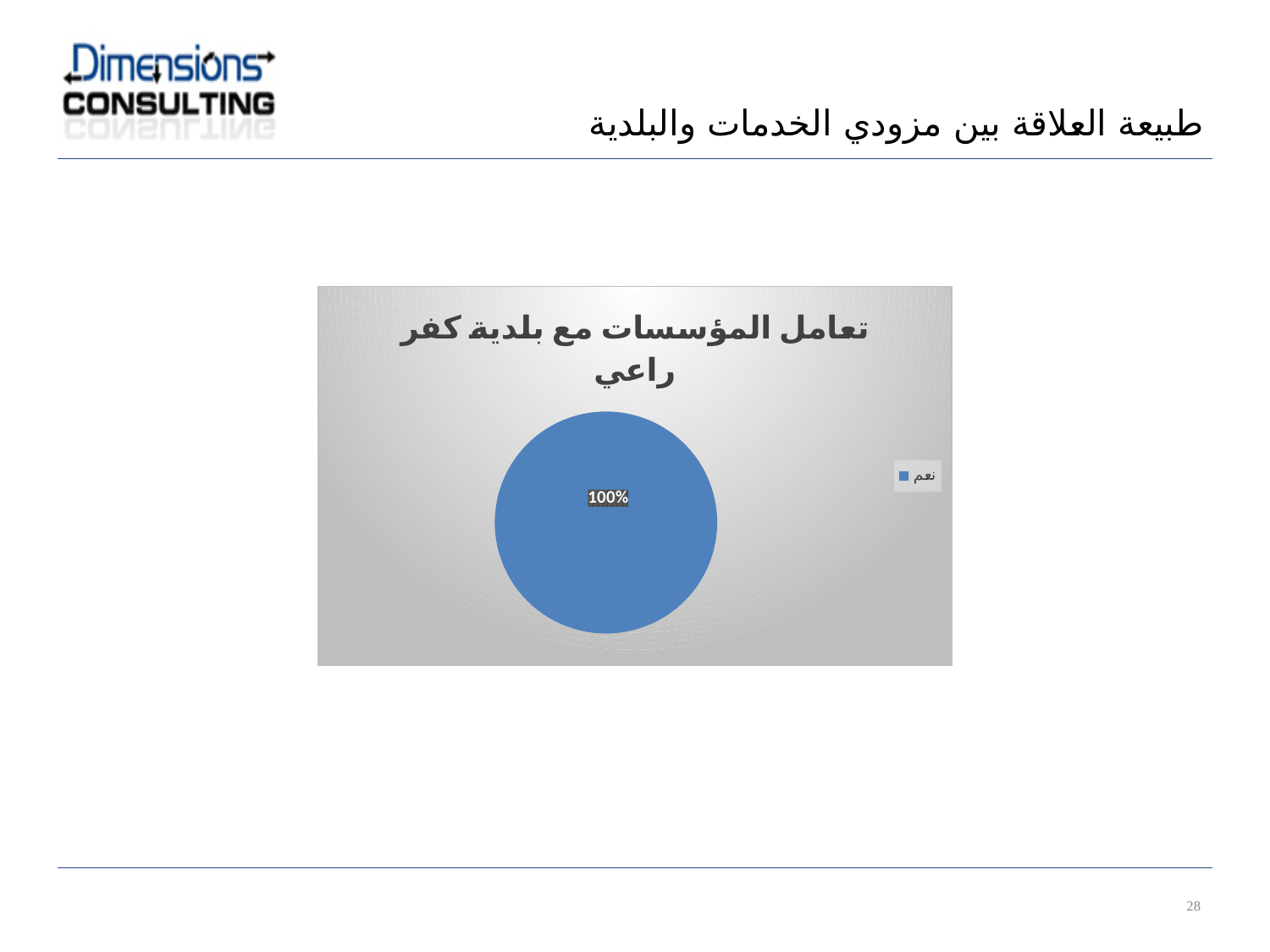
What value is printed on the pie slice? 100% What share of the pie does the slice labelled نعم take? 100% How many entries does the legend list? 1 What is the title of the chart? تعامل المؤسسات مع بلدية كفر راعي What kind of chart is shown on the slide? pie chart How many slices does the pie chart have? 1 Which category has the largest share of the pie? نعم What is the legend entry for the pie chart? نعم